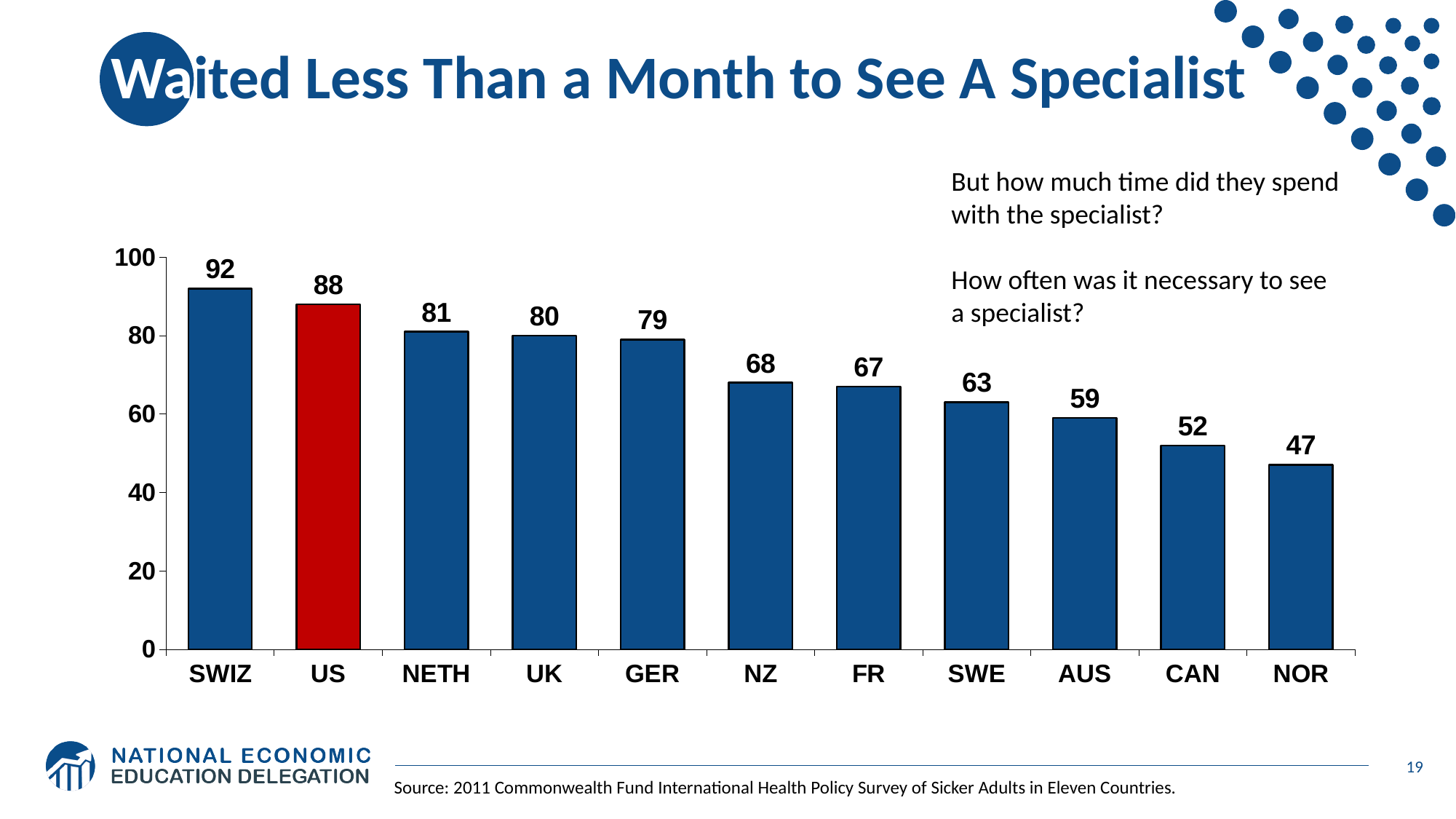
What is the value for GER? 79 What kind of chart is shown on the slide? bar chart How many countries are shown in the chart? 11 Which bar is coloured red rather than blue? US What is the value for the US? 88 What is the value for CAN? 52 Which is larger, the value for NZ or the value for SWE? NZ Which country has the highest value? SWIZ Is the value for AUS greater or less than 60? less What is the difference between the values for US and NETH? 7 Which country has the lowest value? NOR What is the difference between the values for SWIZ and NOR? 45